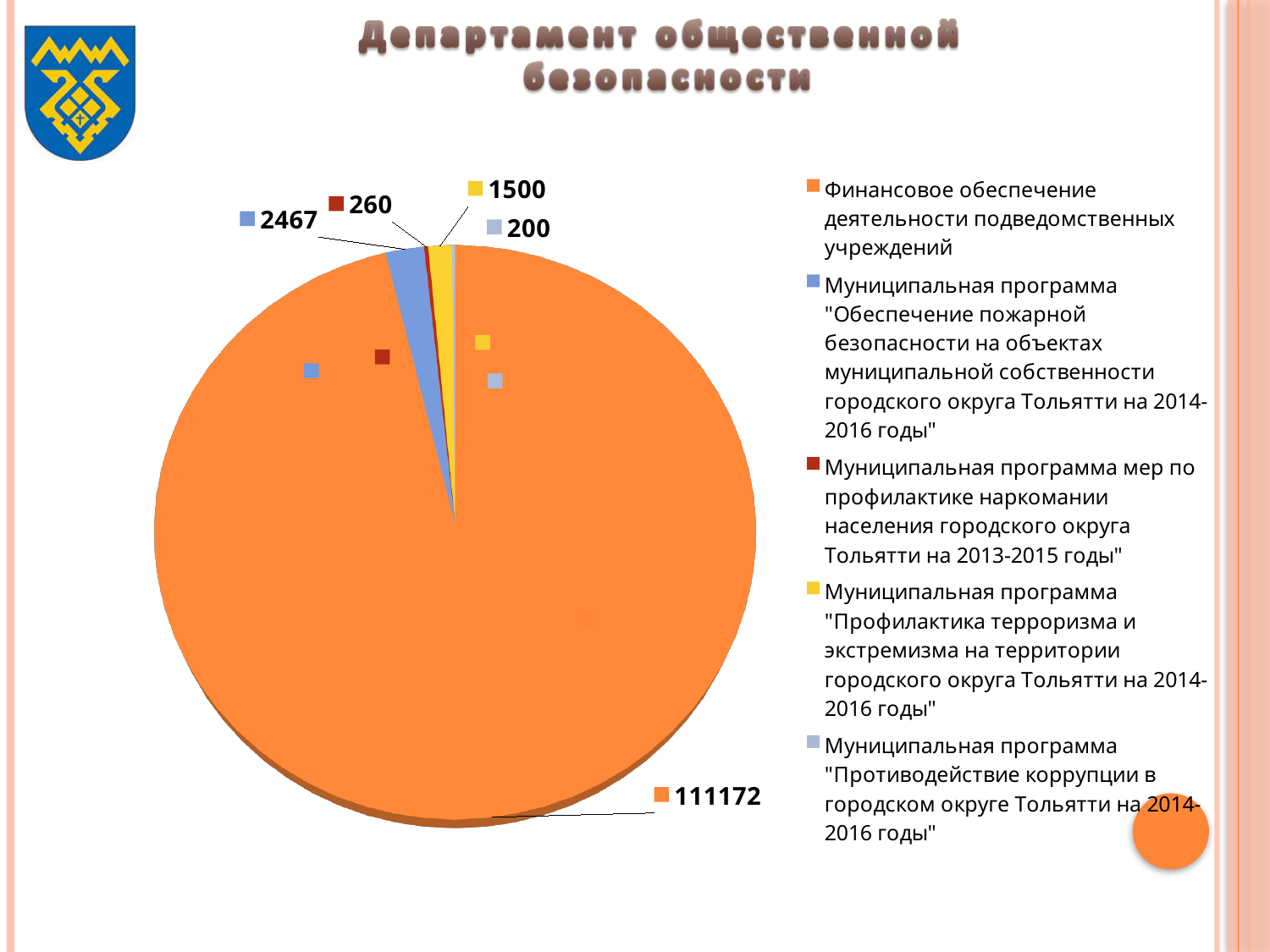
Which category has the smallest slice of the pie? Муниципальная программа "Противодействие коррупции в городском округе Тольятти на 2014-2016 годы" What is the value for the municipal programme "Профилактика терроризма и экстремизма" for 2014-2016? 1500 Which category has the largest slice of the pie? Финансовое обеспечение деятельности подведомственных учреждений What is the value for "Финансовое обеспечение деятельности подведомственных учреждений"? 111172 What is the value for the municipal programme "Противодействие коррупции в городском округе Тольятти на 2014-2016 годы"? 200 What kind of chart is shown on the slide? Pie chart Which is larger: the value for the anti-terrorism programme or the value for the drug addiction prevention programme? The anti-terrorism programme (1500) What is the value for the municipal programme on prevention of drug addiction ("профилактике наркомании") for 2013-2015? 260 What colour is the slice for "Финансовое обеспечение деятельности подведомственных учреждений"? Orange How many slices does the pie chart have? 5 What is the value for the municipal programme "Обеспечение пожарной безопасности на объектах муниципальной собственности городского округа Тольятти на 2014-2016 годы"? 2467 What is the difference between the value for the fire safety programme (2467) and the anti-terrorism programme (1500)? 967